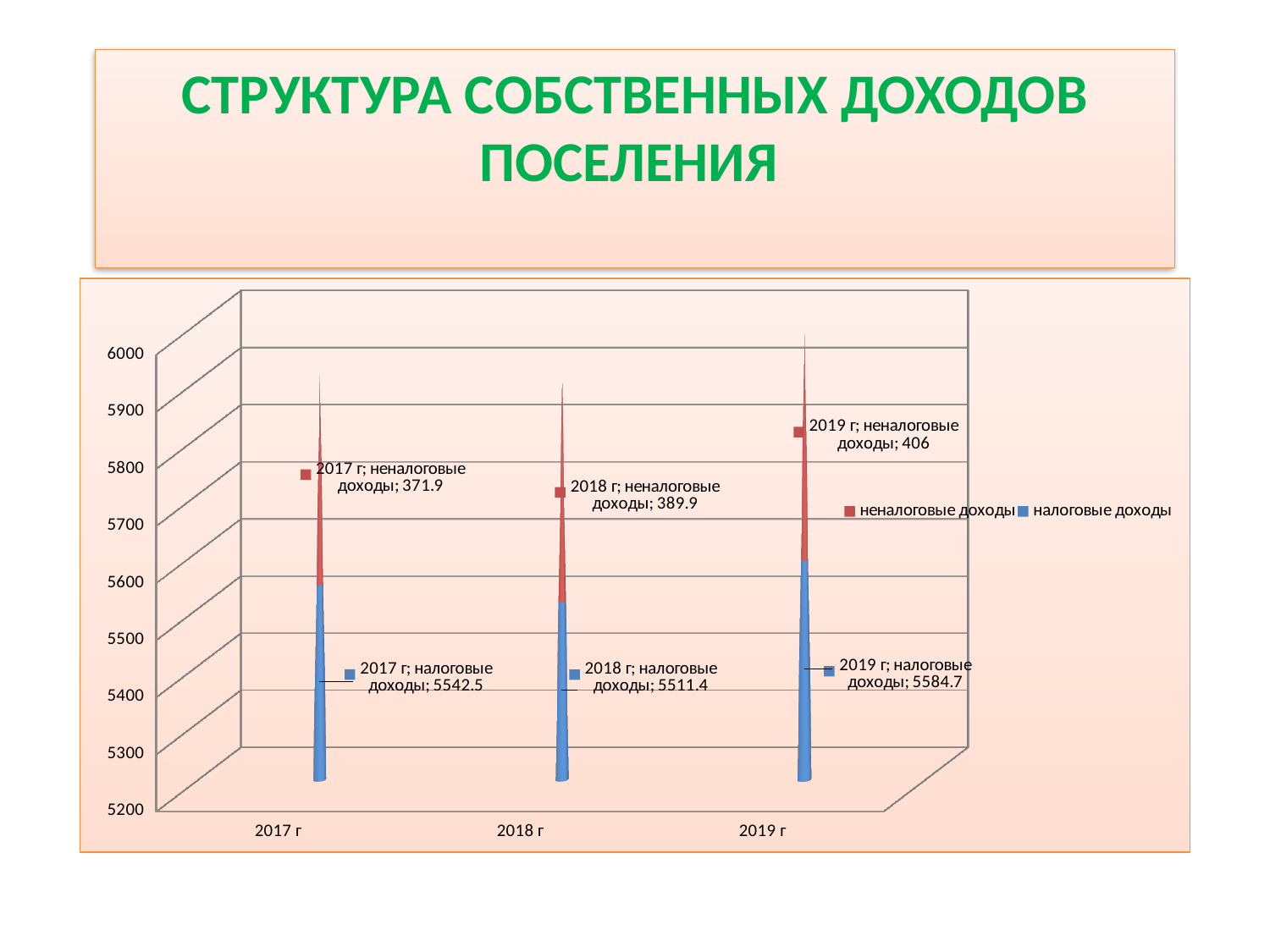
What is the difference between налоговые доходы in 2019 г and 2017 г? 42.2 How many series does the legend list? 2 What is the value of неналоговые доходы for 2018 г? 389.9 What is the total of налоговые доходы and неналоговые доходы for 2019 г? 5990.7 How many years are shown on the x axis? 3 Which year has the lowest value of неналоговые доходы? 2017 г Which year has the highest value of налоговые доходы? 2019 г Which year has the lowest value of налоговые доходы? 2018 г What is the value of неналоговые доходы for 2019 г? 406 Is неналоговые доходы larger in 2018 г or in 2017 г? 2018 г Do the values of неналоговые доходы rise or fall from 2017 г to 2019 г? rise What is the value of налоговые доходы for 2017 г? 5542.5